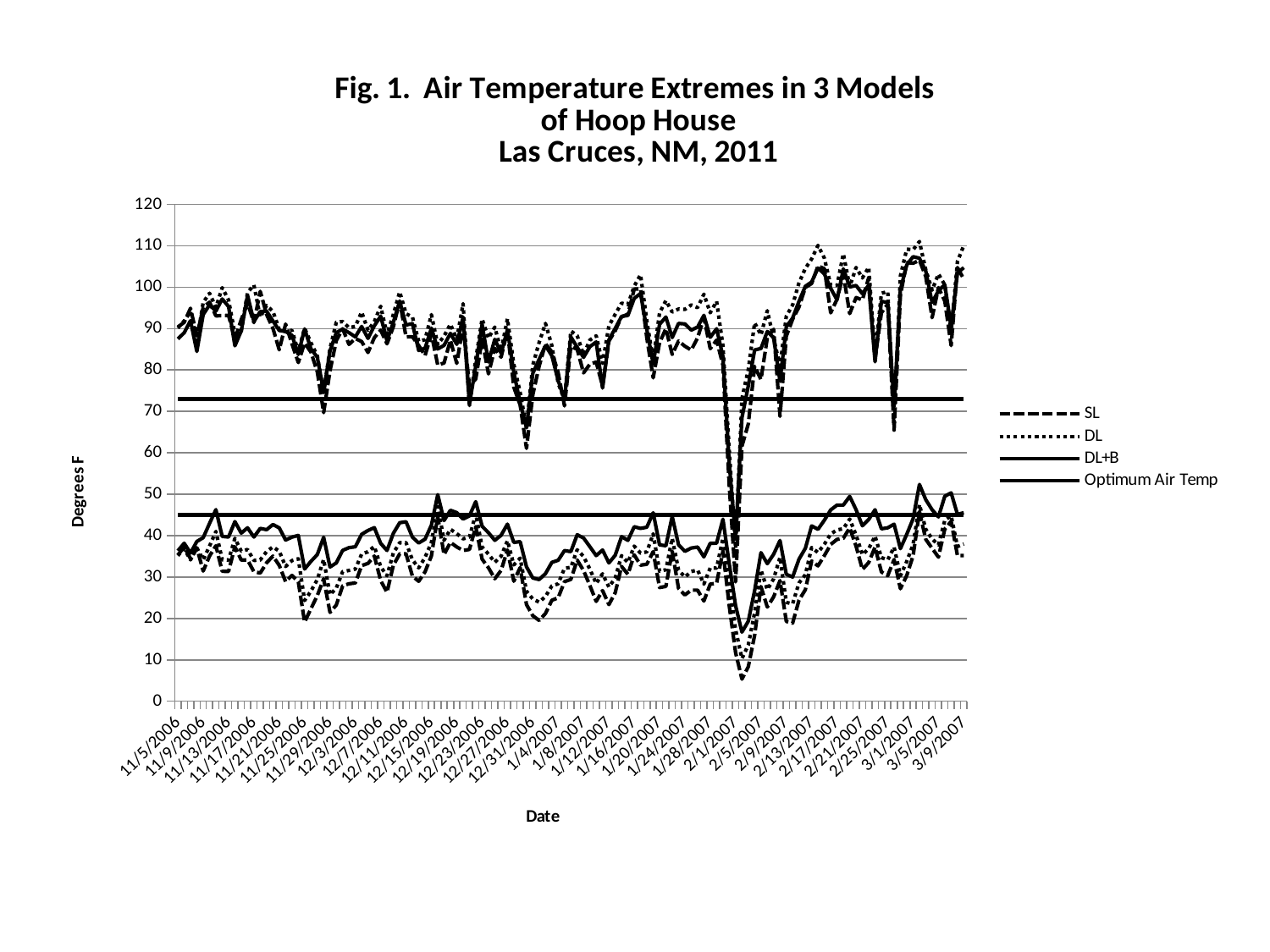
Is the upper Optimum Air Temp line greater or less than 80? less Is the lowest minimum temperature reached by the SL series around 2/1/2007 greater or less than 10? less Is the highest maximum temperature reached by the DL series around 2/13/2007 greater or less than 100? greater What kind of chart is shown on the slide? line chart What is the label of the vertical axis? Degrees F What is the highest value shown on the vertical axis? 120 Which series reaches the lowest minimum temperature around 2/1/2007, SL or DL+B? SL How many series does the legend list? 4 What is the label of the horizontal axis? Date